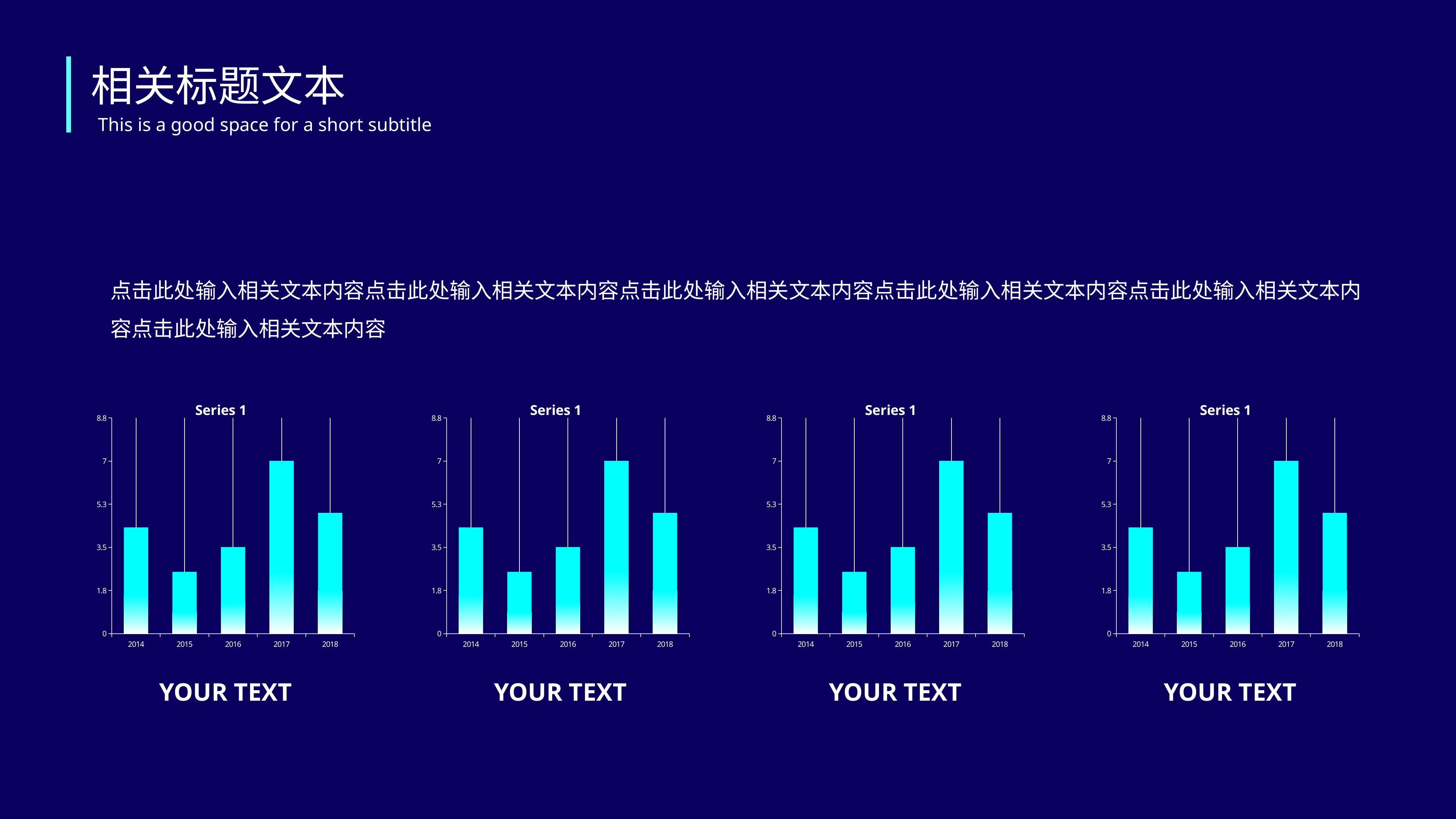
In the third chart from the left, which year has the lowest value? 2015 What type of chart is the second chart from the left? bar chart How many categories are shown on the x axis of the rightmost chart? 5 In the second chart from the left, which is larger, the value for 2014 or the value for 2015? 2014 In the rightmost chart, which year has the highest value? 2017 In the second chart from the left, what is the value for 2016? 3.5 In the third chart from the left, is the value for 2014 greater or less than 3.5? greater In the leftmost chart, is the value for 2015 greater or less than 3.5? less In the rightmost chart, is the value for 2018 greater or less than 5.3? less In the leftmost chart, what is the value for 2017? 7 In the leftmost chart, what is the difference between the values for 2017 and 2016? 3.5 What is the title of the leftmost chart? Series 1